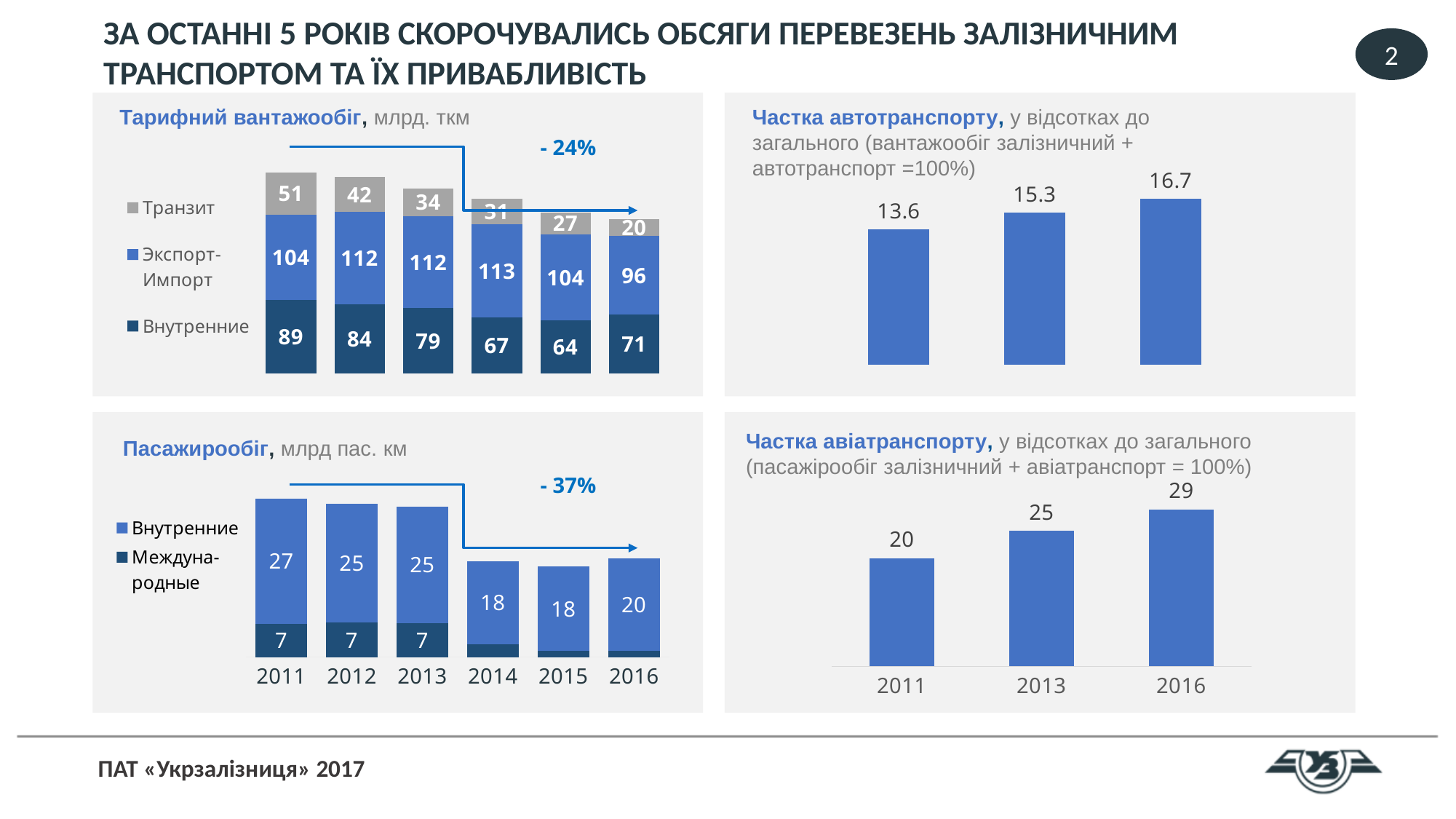
In the 'Пасажирообіг' chart, is the Внутренние value for 2012 larger or smaller than the value for 2015? larger What type of chart is the 'Частка авіатранспорту' chart? bar chart In the 'Частка авіатранспорту' chart, what is the difference between the 2016 and 2011 values? 9 In the 'Пасажирообіг' chart, how many years are shown on the x axis? 6 In the 'Тарифний вантажообіг' chart, how many series does the legend list? 3 In the 'Частка автотранспорту' chart, which bar is the highest? the third (rightmost) bar, 16.7 In the 'Тарифний вантажообіг' chart, what is the total of the last (rightmost) stacked bar? 187 In the 'Пасажирообіг' chart, what is the Международные value for 2013? 7 In the 'Пасажирообіг' chart, what is the Внутренние value for 2011? 27 In the 'Частка автотранспорту' chart, what is the value of the first (leftmost) bar? 13.6 In the 'Тарифний вантажообіг' chart, what is the Транзит value for the first (leftmost) bar? 51 In the 'Частка авіатранспорту' chart, what is the value for 2016? 29